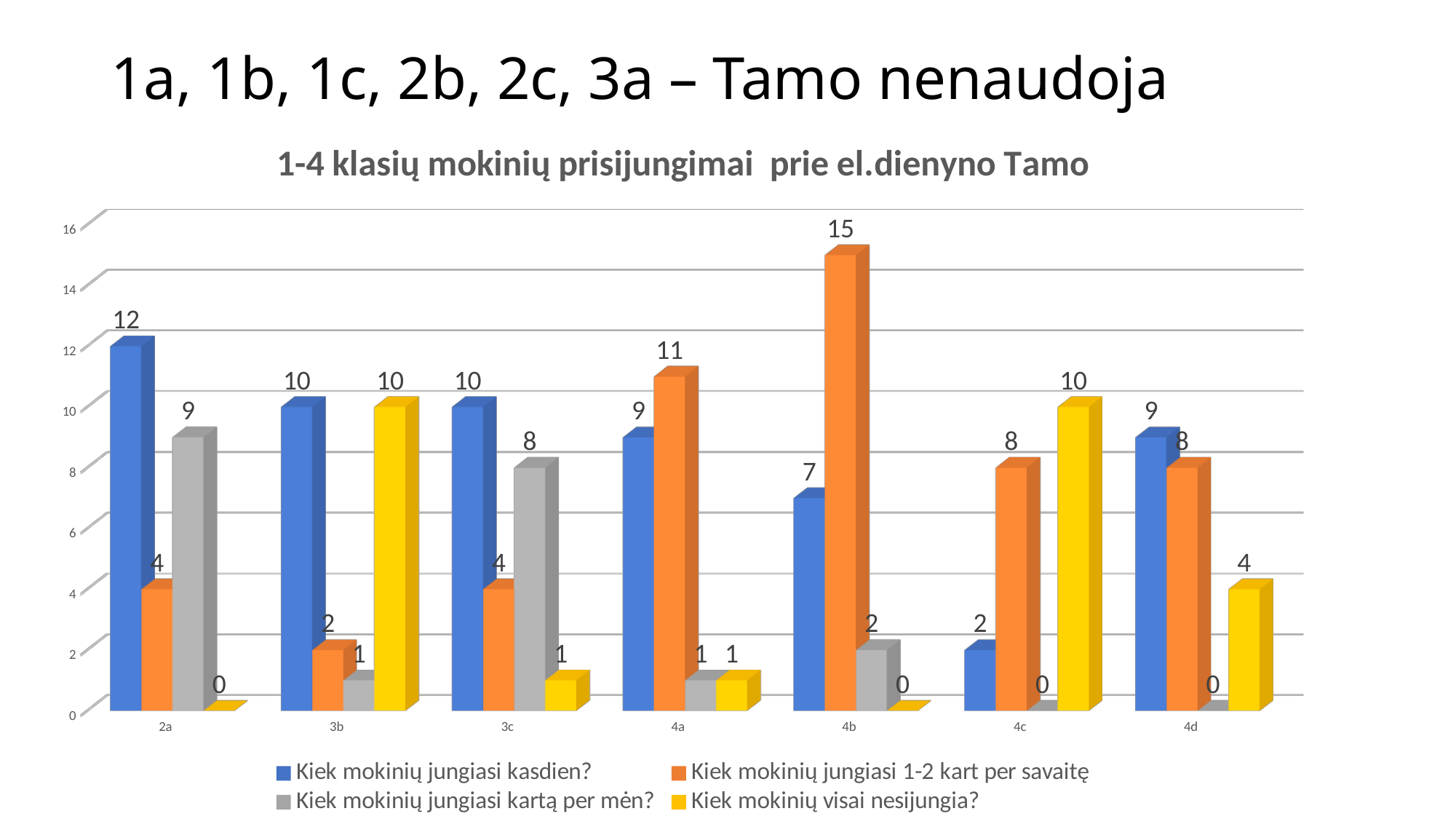
For class 3c, which is larger: 'Kiek mokinių jungiasi kasdien?' or 'Kiek mokinių jungiasi kartą per mėn?'? Kiek mokinių jungiasi kasdien? What is the difference between 'Kiek mokinių jungiasi 1-2 kart per savaitę' and 'Kiek mokinių jungiasi kasdien?' for class 4b? 8 Which class has the lowest value for 'Kiek mokinių jungiasi kasdien?'? 4c Which class has the highest value for 'Kiek mokinių jungiasi 1-2 kart per savaitę'? 4b What is the value of 'Kiek mokinių visai nesijungia?' for class 4c? 10 What type of chart is shown on the slide? bar chart What is the chart's title? 1-4 klasių mokinių prisijungimai prie el.dienyno Tamo What is the value of 'Kiek mokinių jungiasi kasdien?' for class 2a? 12 How many series does the legend list? 4 What is the value of 'Kiek mokinių jungiasi 1-2 kart per savaitę' for class 4b? 15 What is the value of 'Kiek mokinių jungiasi kartą per mėn?' for class 2a? 9 How many class categories are shown on the x axis? 7